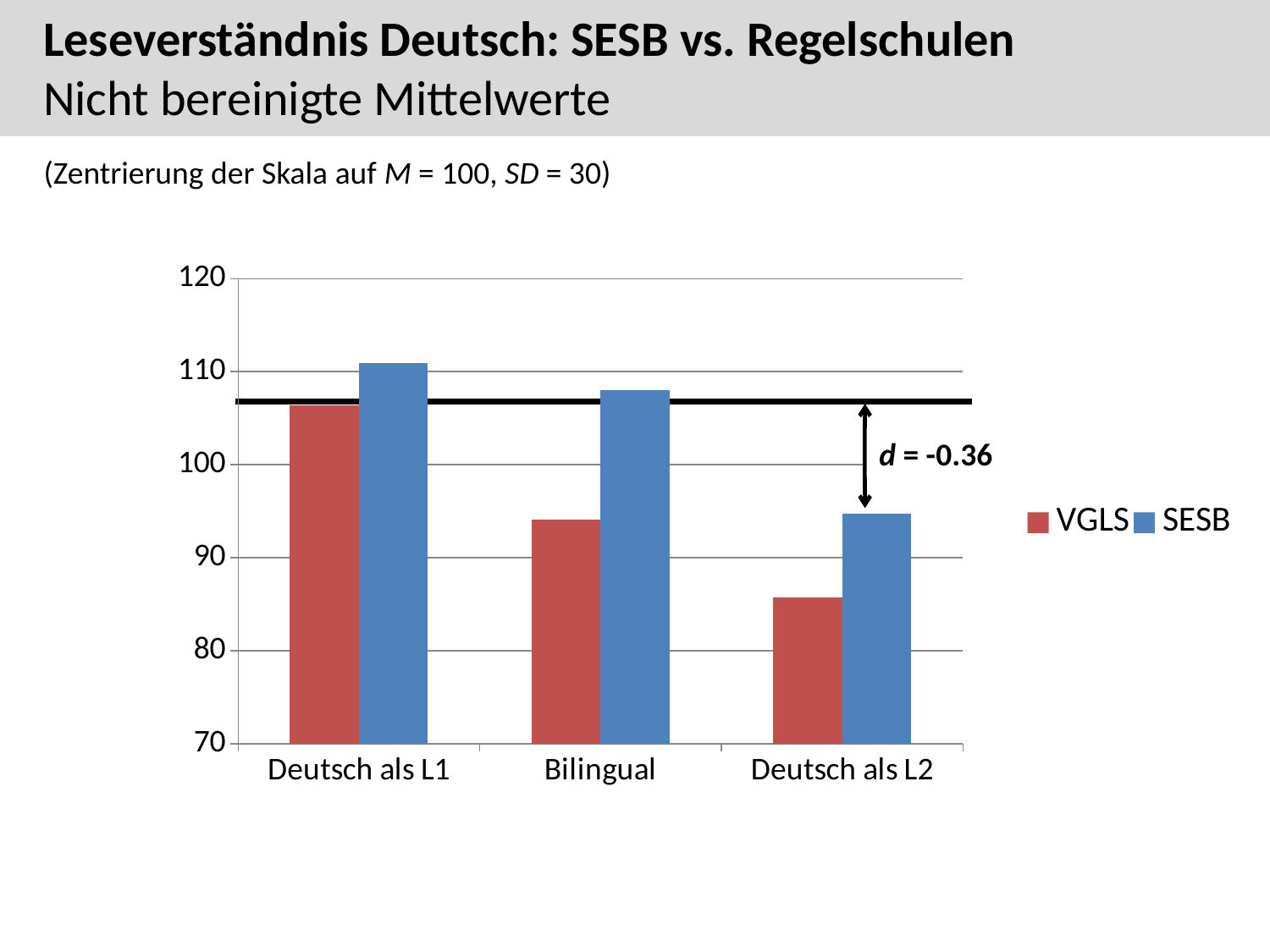
Is the VGLS value for Deutsch als L2 greater or less than 90? less For which category is the SESB bar highest? Deutsch als L1 Is the SESB value for Bilingual greater or less than 100? greater How many series does the legend list? 2 How many categories are shown on the x axis? 3 What kind of chart is shown on the slide? bar chart Do the VGLS values rise or fall from Deutsch als L1 to Deutsch als L2? fall Is the VGLS value for Bilingual greater or less than 100? less For Bilingual, which series has the larger value, VGLS or SESB? SESB For which category is the VGLS bar lowest? Deutsch als L2